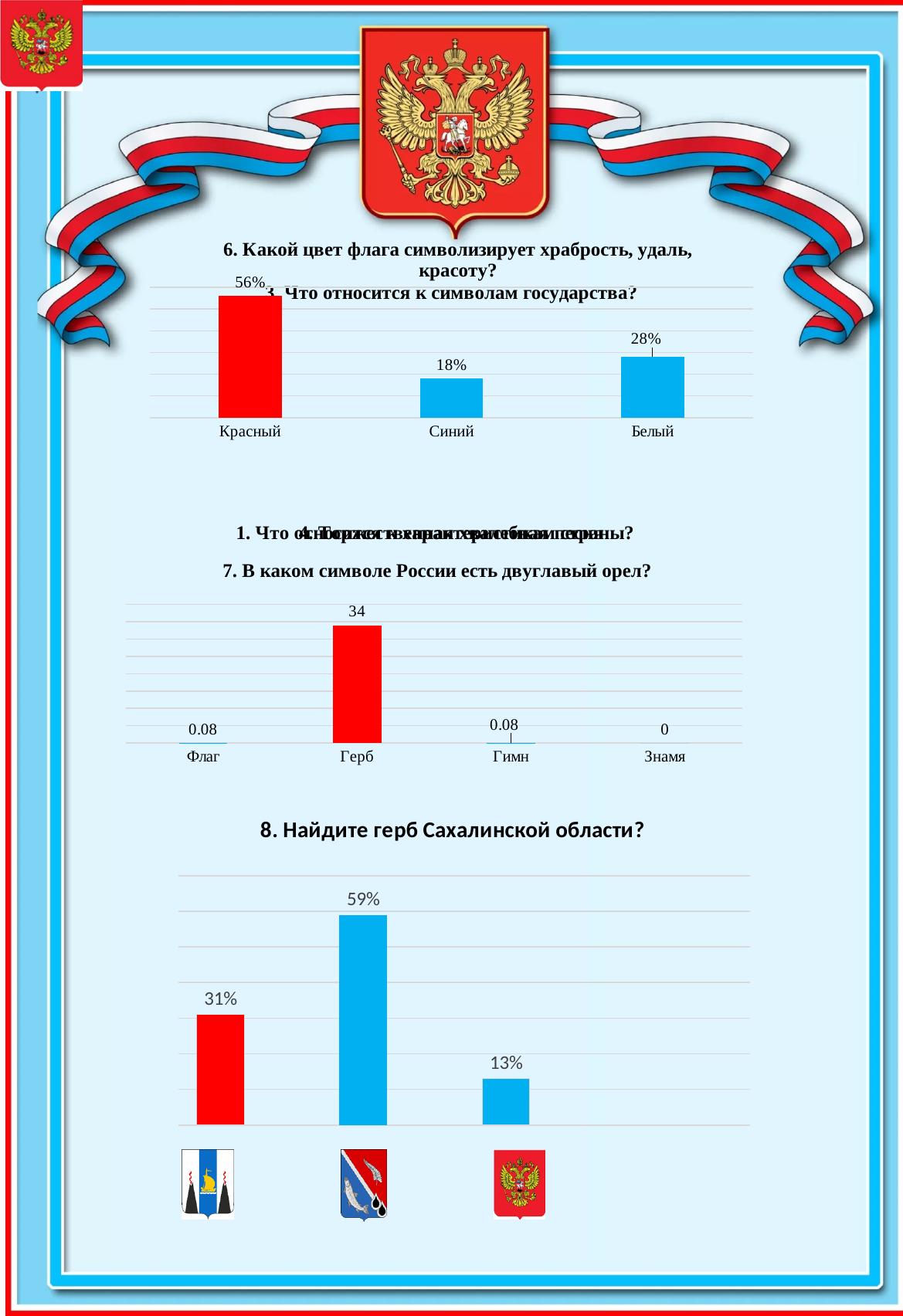
In the chart titled "7. В каком символе России есть двуглавый орел?", what is the value for Герб? 34 In the chart titled "6. Какой цвет флага символизирует храбрость, удаль, красоту?", what is the difference between the values for Красный and Белый? 28% In the chart titled "6. Какой цвет флага символизирует храбрость, удаль, красоту?", which category has the lowest value? Синий In the chart titled "8. Найдите герб Сахалинской области?", what is the value of the third (rightmost) bar? 13% In the chart titled "7. В каком символе России есть двуглавый орел?", how many categories are shown on the x axis? 4 In the chart titled "6. Какой цвет флага символизирует храбрость, удаль, красоту?", what is the value for Синий? 18% In the chart titled "8. Найдите герб Сахалинской области?", what is the value of the tallest bar? 59% In the chart titled "7. В каком символе России есть двуглавый орел?", which category has the highest value? Герб In the chart titled "6. Какой цвет флага символизирует храбрость, удаль, красоту?", what is the value for Красный? 56% In the chart titled "7. В каком символе России есть двуглавый орел?", what is the value for Знамя? 0 In the chart titled "8. Найдите герб Сахалинской области?", what is the difference between the second bar and the first bar? 28% What type of chart is the chart titled "8. Найдите герб Сахалинской области?"? Bar chart